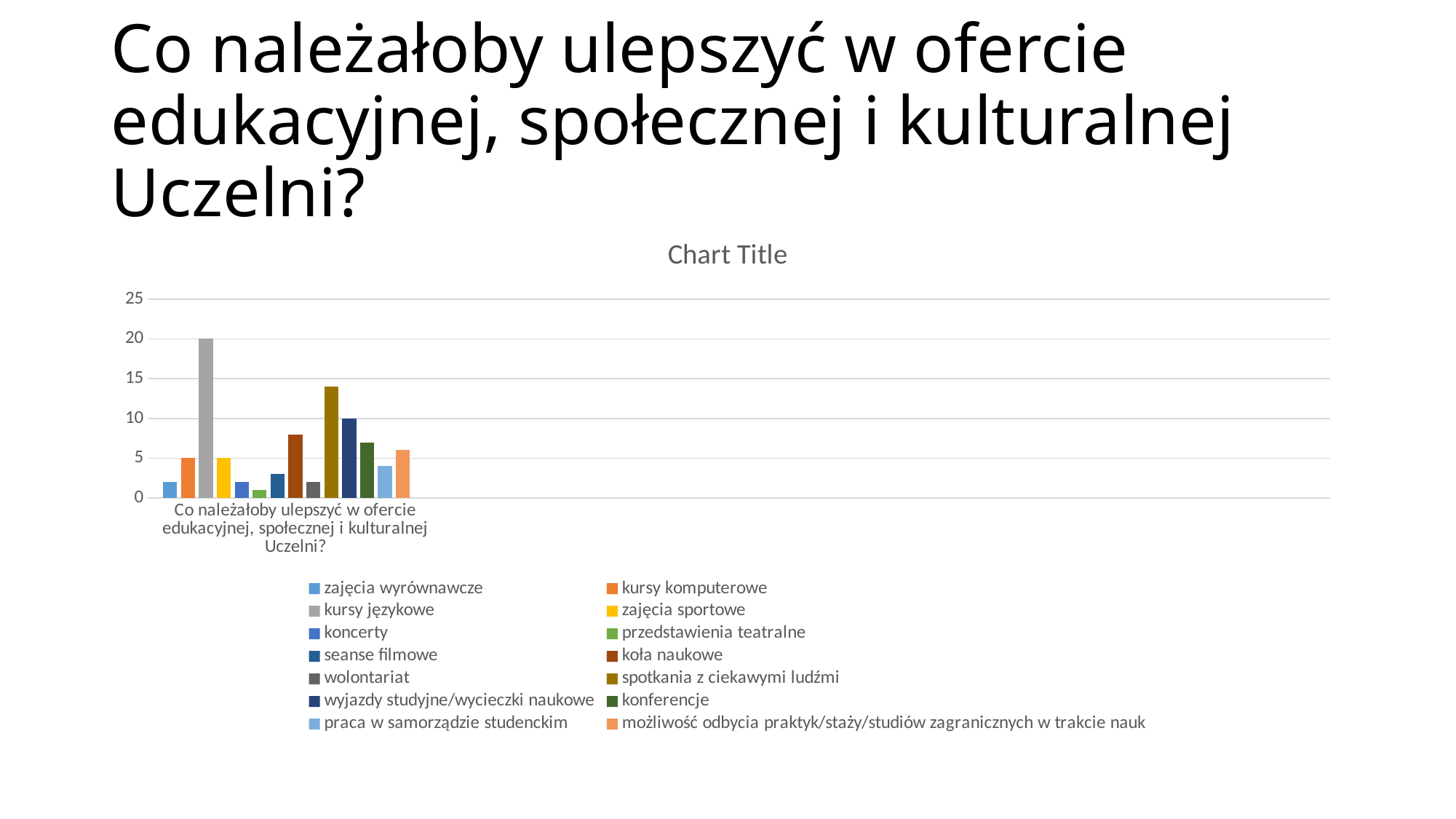
Which is larger, the value for konferencje or the value for seanse filmowe? konferencje Which series has the lowest bar? przedstawienia teatralne Which series has the highest bar? kursy językowe What is the value for kursy komputerowe? 5 Is the value for spotkania z ciekawymi ludźmi greater or less than 10? greater What is the value for wyjazdy studyjne/wycieczki naukowe? 10 What kind of chart is shown on the slide? bar chart Is the value for koła naukowe greater or less than 10? less How many series does the legend list? 14 What is the value for kursy językowe? 20 What is the difference between the values for kursy językowe and wyjazdy studyjne/wycieczki naukowe? 10 What is the title shown above the chart? Chart Title